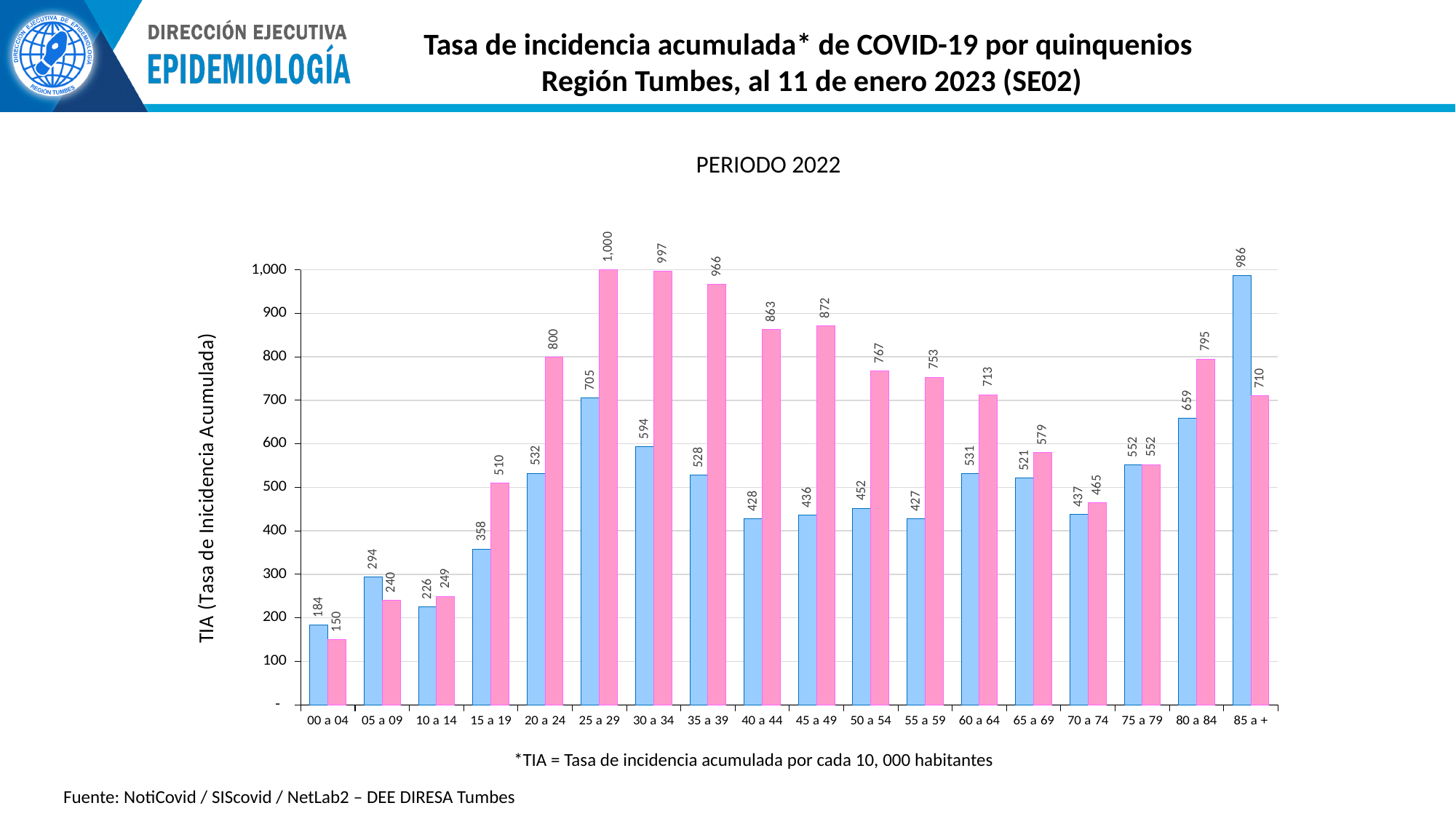
What kind of chart is shown on the slide? bar chart What is the title shown above the chart? PERIODO 2022 Which age group has the highest blue bar? 85 a + For the 05 a 09 age group, which bar is larger, blue or pink? blue Which age group has the lowest pink bar? 00 a 04 What is the difference between the blue and pink bars for the 85 a + age group? 276 What is the value of the blue bar for the 25 a 29 age group? 705 What is the difference between the pink and blue bars for the 20 a 24 age group? 268 What is the value of the pink bar for the 45 a 49 age group? 872 What is the value of the pink bar for the 85 a + age group? 710 Is the value of the pink bar for 40 a 44 greater or less than 800? greater How many age groups are shown on the x axis? 18